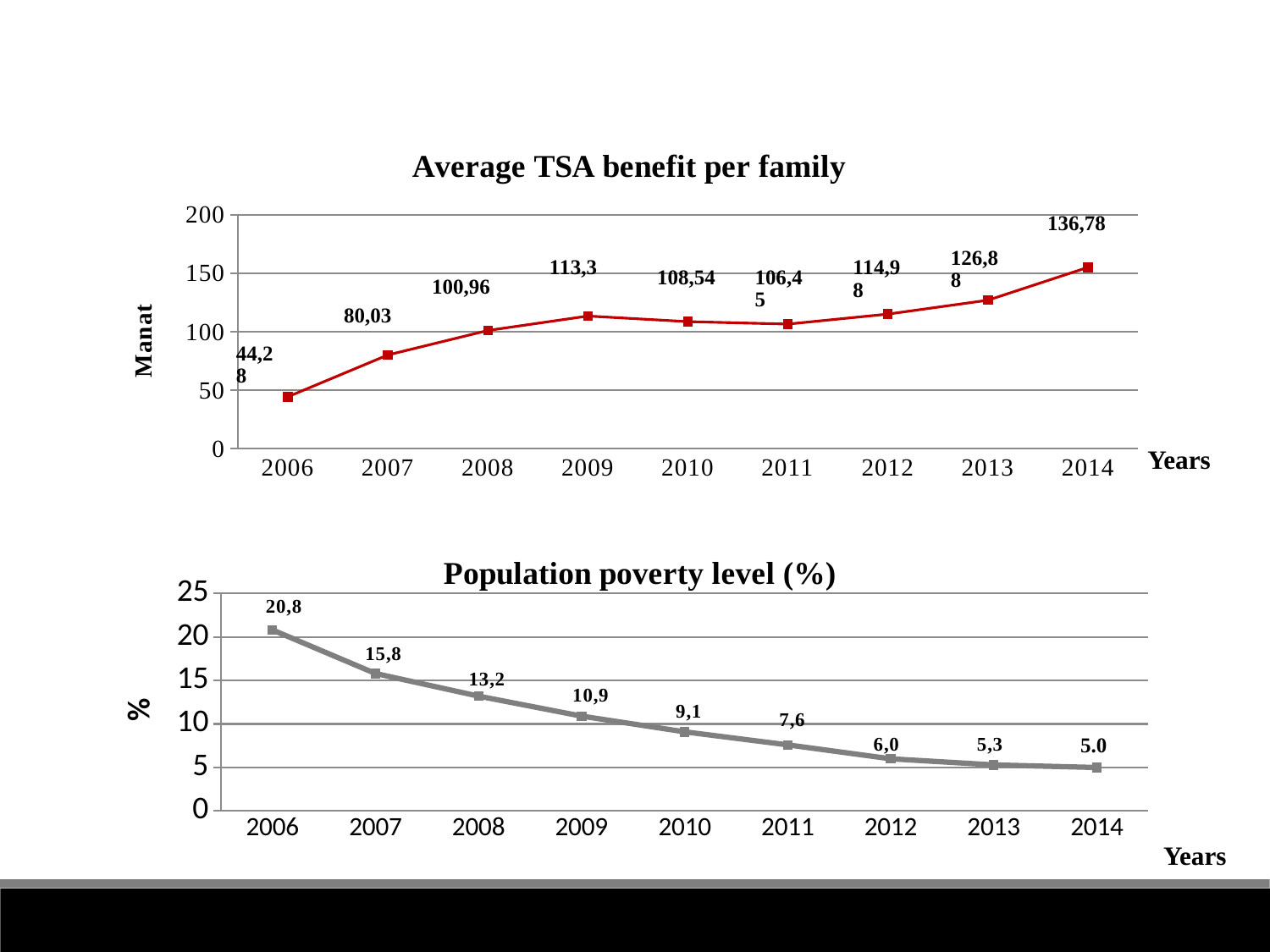
In the 'Average TSA benefit per family' chart, what is the difference between the 2009 value and the 2007 value? 33,27 In the 'Population poverty level (%)' chart, what is the value for 2011? 7,6 How many years are plotted in the 'Population poverty level (%)' chart? 9 In the 'Population poverty level (%)' chart, what is the difference between the 2006 value and the 2014 value? 15,8 In the 'Average TSA benefit per family' chart, is the value for 2009 greater or less than 2010? greater In the 'Average TSA benefit per family' chart, which year has the highest value? 2014 In the 'Population poverty level (%)' chart, what is the value for 2006? 20,8 In the 'Average TSA benefit per family' chart, what is the value for 2008? 100,96 In the 'Population poverty level (%)' chart, do the values rise or fall from 2006 to 2014? Fall What type of chart is the 'Average TSA benefit per family' chart? Line chart In the 'Average TSA benefit per family' chart, which year has the lowest value? 2006